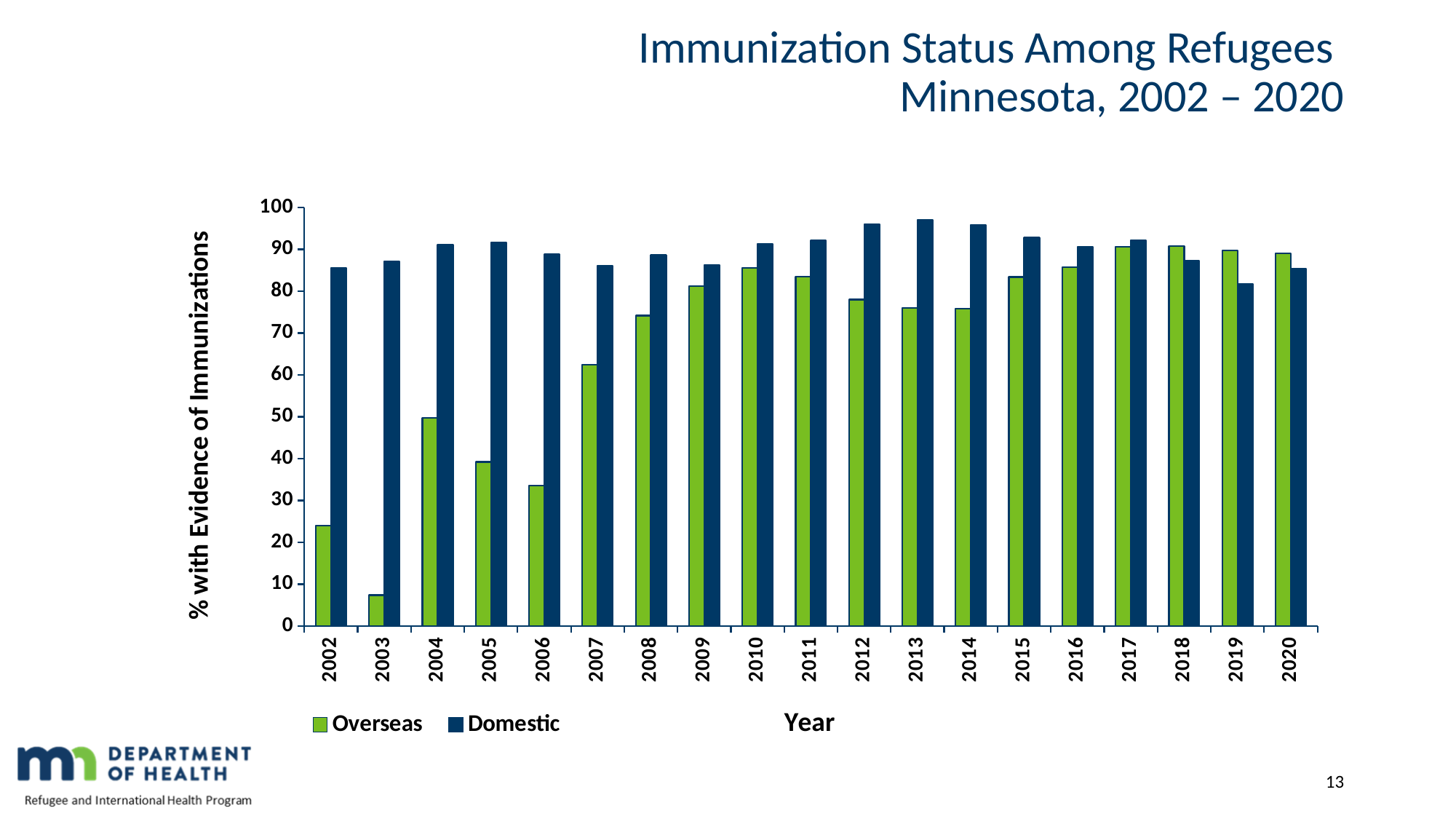
Is the Overseas value for 2007 greater or less than 60? greater What is the label of the y axis? % with Evidence of Immunizations What kind of chart is shown on the slide? bar chart Which year has the lowest Overseas value? 2003 Do the Overseas values rise or fall from 2003 to 2010? rise How many series does the legend list? 2 Is the Domestic value for 2013 greater or less than 90? greater Is the Overseas value for 2003 greater or less than 10? less In 2002, which is larger, the Overseas value or the Domestic value? Domestic Which year has the lowest Domestic value? 2019 How many years are shown on the x axis? 19 In 2019, which is larger, the Overseas value or the Domestic value? Overseas